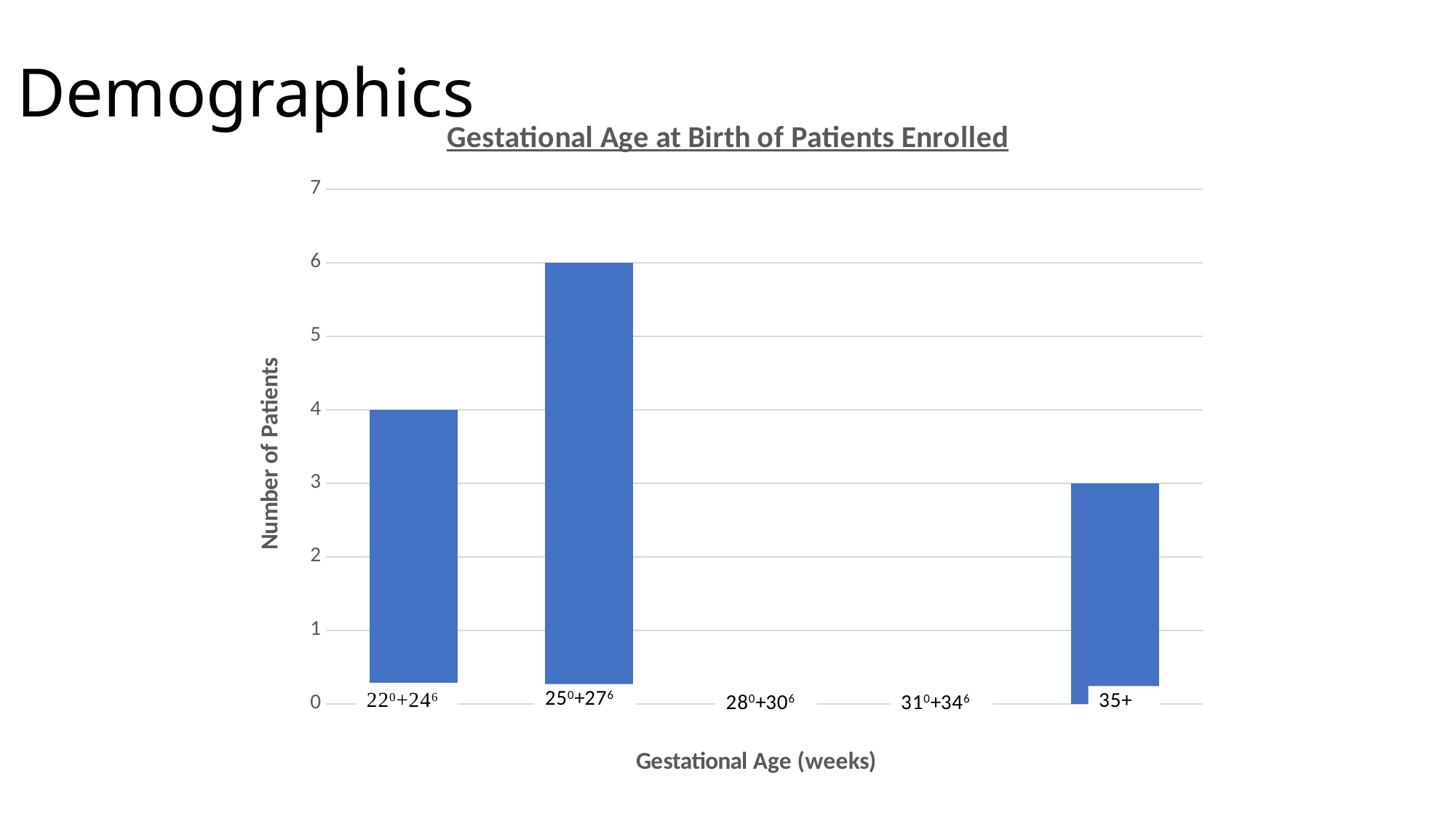
Which group has more patients, 22⁰+24⁶ or 35+? 22⁰+24⁶ What is the number of patients for the 35+ gestational age group? 3 What is the label of the y axis? Number of Patients What is the number of patients for the 22⁰+24⁶ gestational age group? 4 Is the number of patients for the 25⁰+27⁶ group greater or less than 5? greater How many gestational age categories are shown on the x axis? 5 What is the difference in number of patients between the 25⁰+27⁶ group and the 22⁰+24⁶ group? 2 What is the number of patients for the 25⁰+27⁶ gestational age group? 6 What kind of chart is shown on the slide? Bar chart What is the difference in number of patients between the 25⁰+27⁶ group and the 35+ group? 3 What is the title of the chart? Gestational Age at Birth of Patients Enrolled Which gestational age group has the highest number of patients? 25⁰+27⁶